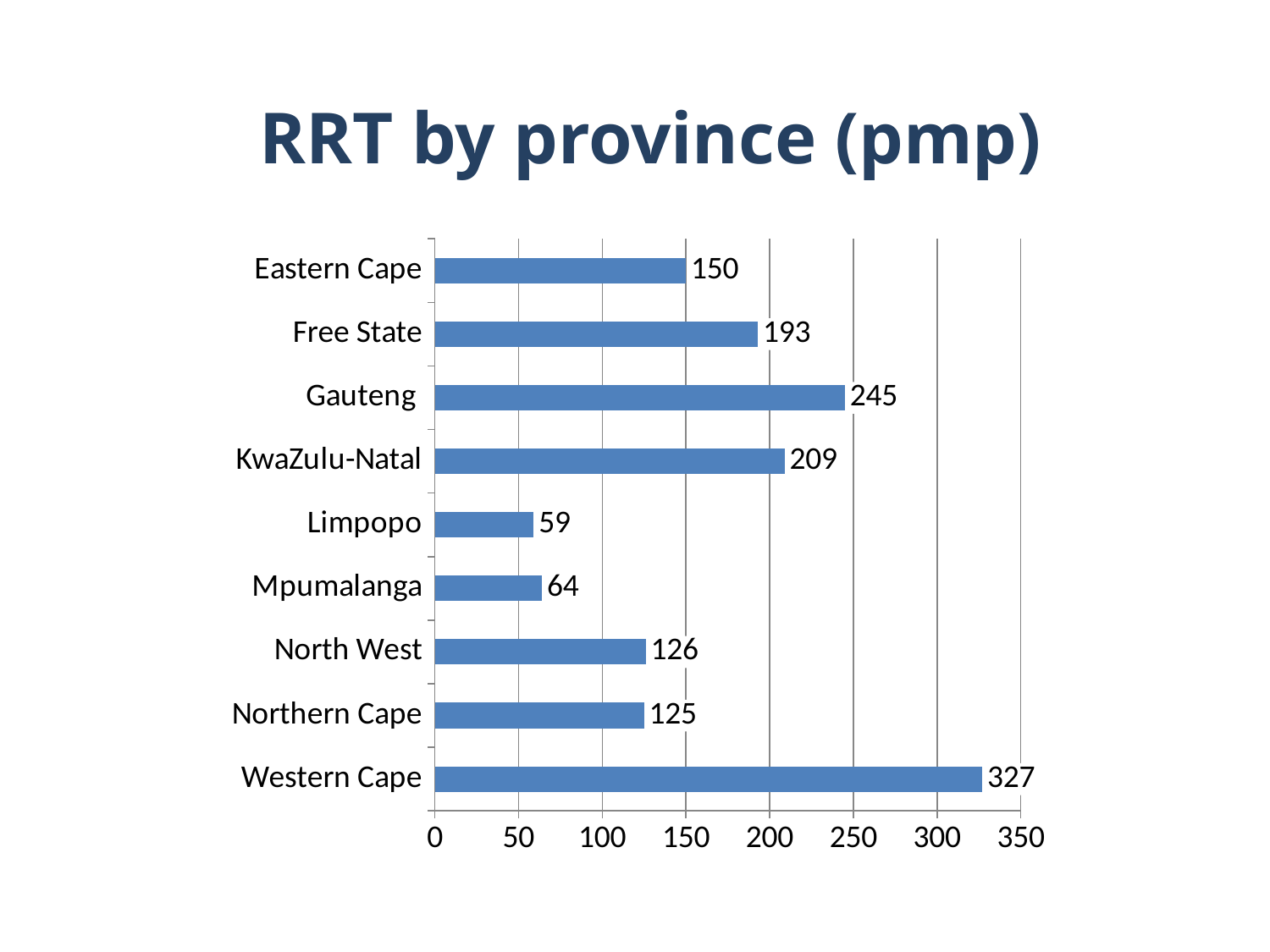
What is the RRT value (pmp) for KwaZulu-Natal? 209 What is the difference between the RRT values for Free State and Eastern Cape? 43 Which has a higher RRT (pmp), Free State or KwaZulu-Natal? KwaZulu-Natal Which province has the lowest RRT (pmp)? Limpopo What is the RRT value (pmp) for Gauteng? 245 What is the title of the chart? RRT by province (pmp) How many provinces are shown in the chart? 9 What is the difference between the RRT values for Western Cape and Gauteng? 82 What is the RRT value (pmp) for Limpopo? 59 Is the RRT value for Mpumalanga greater or less than 100? less What kind of chart is shown on the slide? bar chart Which province has the highest RRT (pmp)? Western Cape